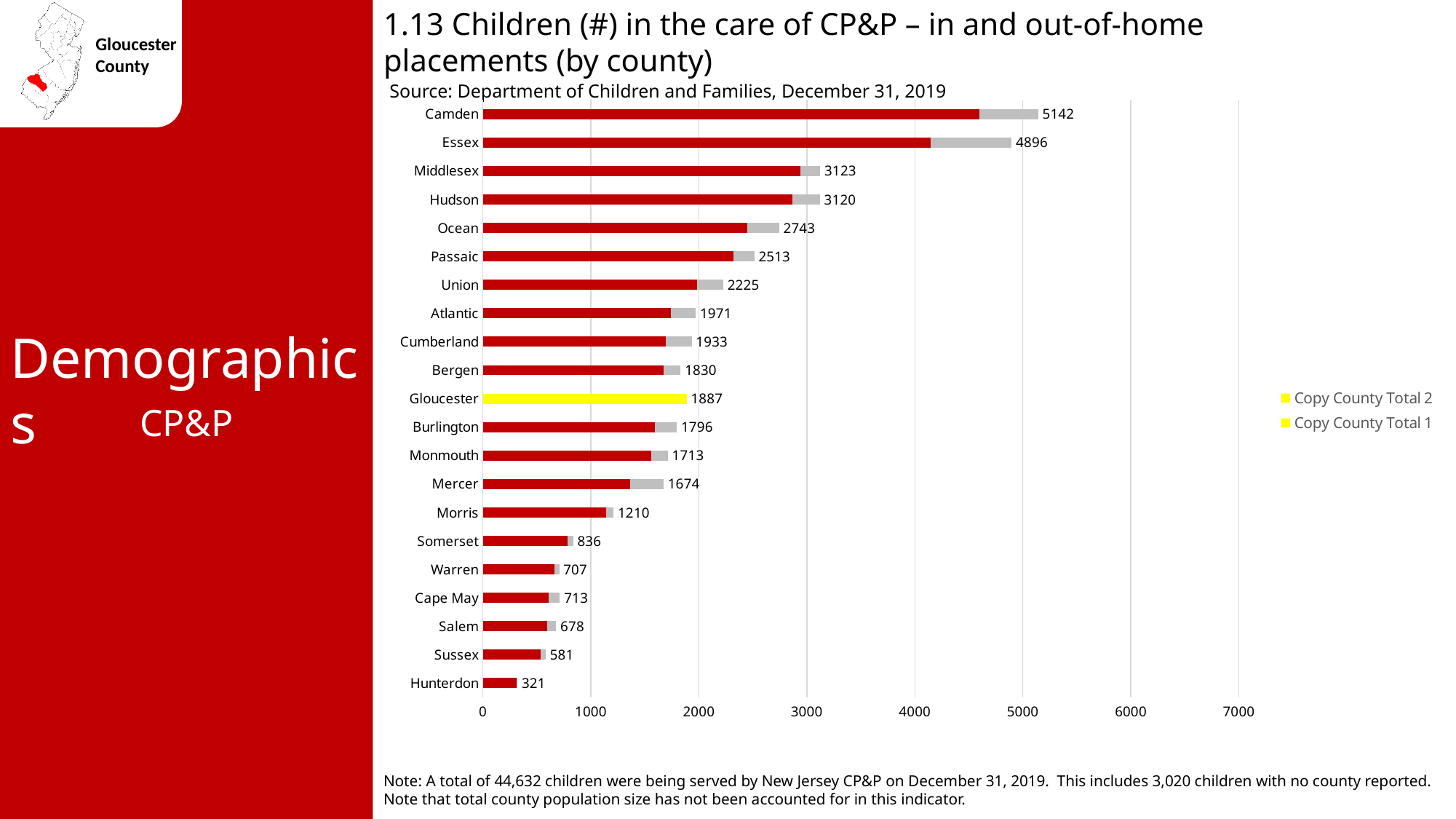
How many entries does the legend list? 2 What is the difference between the totals for Camden and Essex? 246 What kind of chart is shown on the slide? Bar chart Which county has the highest total number of children in the care of CP&P? Camden What is the total number of children in the care of CP&P for Gloucester? 1887 What is the total number of children in the care of CP&P for Hunterdon? 321 Which county's bar is highlighted in yellow? Gloucester Which county has the lowest total number of children in the care of CP&P? Hunterdon Is the total for Middlesex greater or less than 3000? greater How many counties are shown on the chart? 21 What is the total number of children in the care of CP&P for Camden? 5142 Which county has a larger total, Ocean or Passaic? Ocean